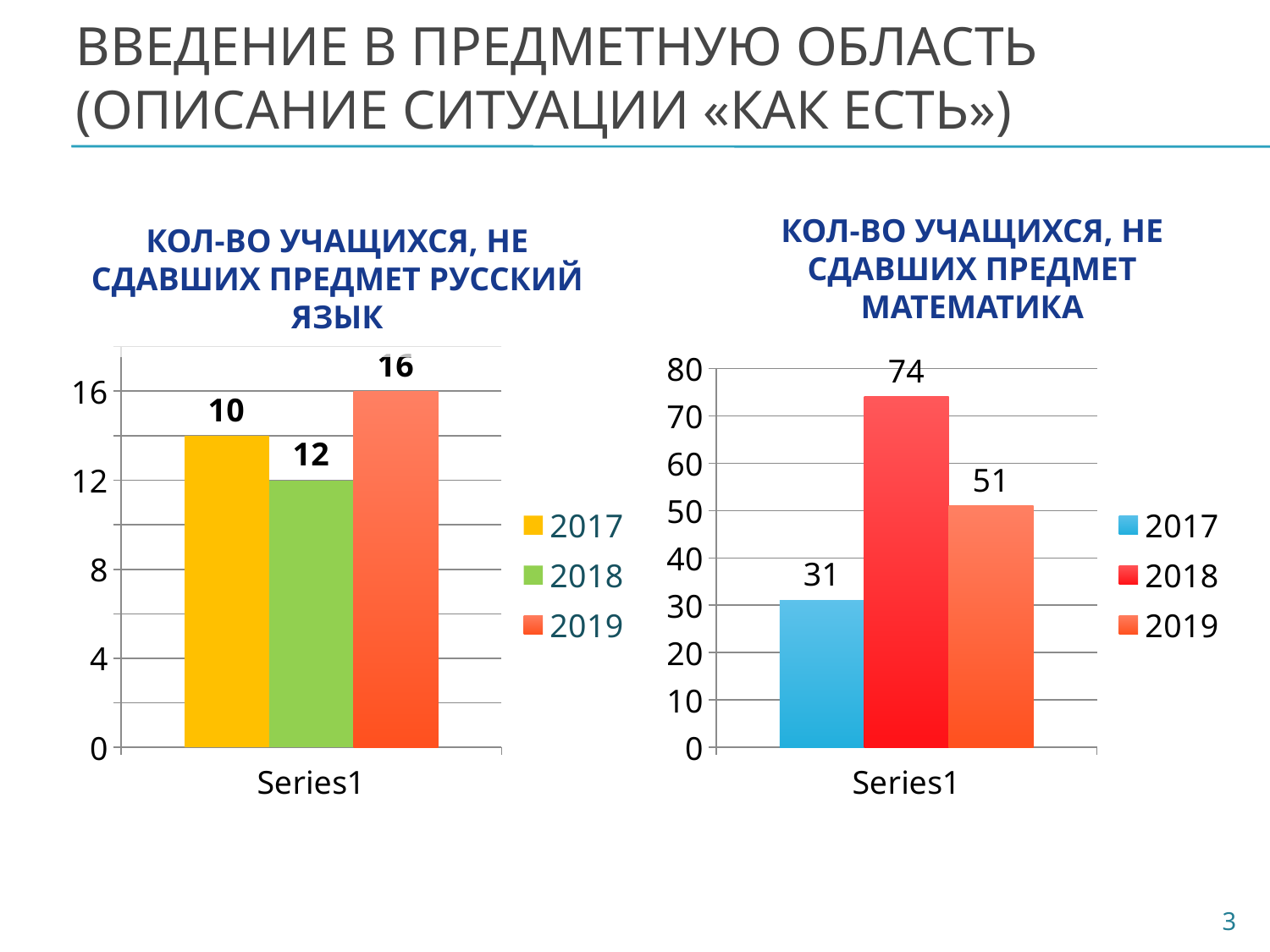
In the chart titled «КОЛ-ВО УЧАЩИХСЯ, НЕ СДАВШИХ ПРЕДМЕТ МАТЕМАТИКА», what is the value for 2017? 31 In the chart titled «КОЛ-ВО УЧАЩИХСЯ, НЕ СДАВШИХ ПРЕДМЕТ РУССКИЙ ЯЗЫК», is the value for 2019 larger or smaller than the value for 2018? larger In the chart titled «КОЛ-ВО УЧАЩИХСЯ, НЕ СДАВШИХ ПРЕДМЕТ МАТЕМАТИКА», what is the value for 2018? 74 In the chart titled «КОЛ-ВО УЧАЩИХСЯ, НЕ СДАВШИХ ПРЕДМЕТ РУССКИЙ ЯЗЫК», which year has the highest value? 2019 In the chart titled «КОЛ-ВО УЧАЩИХСЯ, НЕ СДАВШИХ ПРЕДМЕТ МАТЕМАТИКА», which year has the lowest value? 2017 How many series does the legend of the chart titled «КОЛ-ВО УЧАЩИХСЯ, НЕ СДАВШИХ ПРЕДМЕТ РУССКИЙ ЯЗЫК» list? 3 In the chart titled «КОЛ-ВО УЧАЩИХСЯ, НЕ СДАВШИХ ПРЕДМЕТ МАТЕМАТИКА», which year has the highest value? 2018 In the chart titled «КОЛ-ВО УЧАЩИХСЯ, НЕ СДАВШИХ ПРЕДМЕТ МАТЕМАТИКА», what is the value for 2019? 51 In the chart titled «КОЛ-ВО УЧАЩИХСЯ, НЕ СДАВШИХ ПРЕДМЕТ МАТЕМАТИКА», what is the difference between the values for 2018 and 2019? 23 What kind of chart is the chart titled «КОЛ-ВО УЧАЩИХСЯ, НЕ СДАВШИХ ПРЕДМЕТ МАТЕМАТИКА»? bar chart In the chart titled «КОЛ-ВО УЧАЩИХСЯ, НЕ СДАВШИХ ПРЕДМЕТ РУССКИЙ ЯЗЫК», what is the value for 2019? 16 In the chart titled «КОЛ-ВО УЧАЩИХСЯ, НЕ СДАВШИХ ПРЕДМЕТ МАТЕМАТИКА», is the value for 2019 greater or less than 40? greater